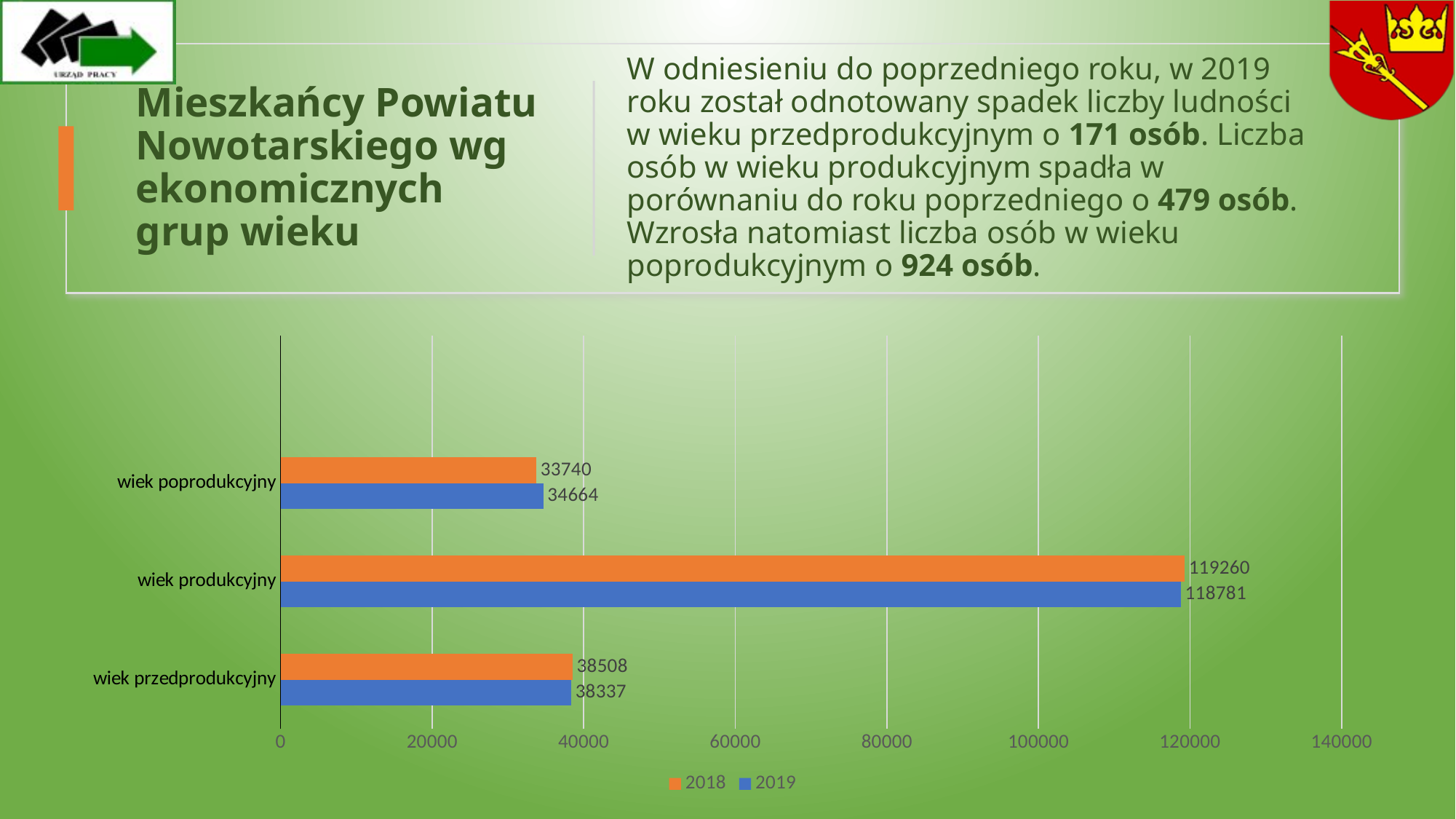
Is the 2019 value for wiek produkcyjny greater or less than 100000? greater What is the difference between the 2018 and 2019 values for wiek produkcyjny? 479 What is the value for wiek produkcyjny in 2019? 118781 How many series does the legend list? 2 What is the difference between the 2019 and 2018 values for wiek poprodukcyjny? 924 Which category has the lowest value in 2019? wiek poprodukcyjny How many categories are shown on the chart? 3 Which category has the highest value in 2018? wiek produkcyjny Which is larger for wiek przedprodukcyjny: the 2018 value or the 2019 value? 2018 What is the value for wiek przedprodukcyjny in 2019? 38337 What kind of chart is shown on the slide? bar chart What is the value for wiek poprodukcyjny in 2018? 33740